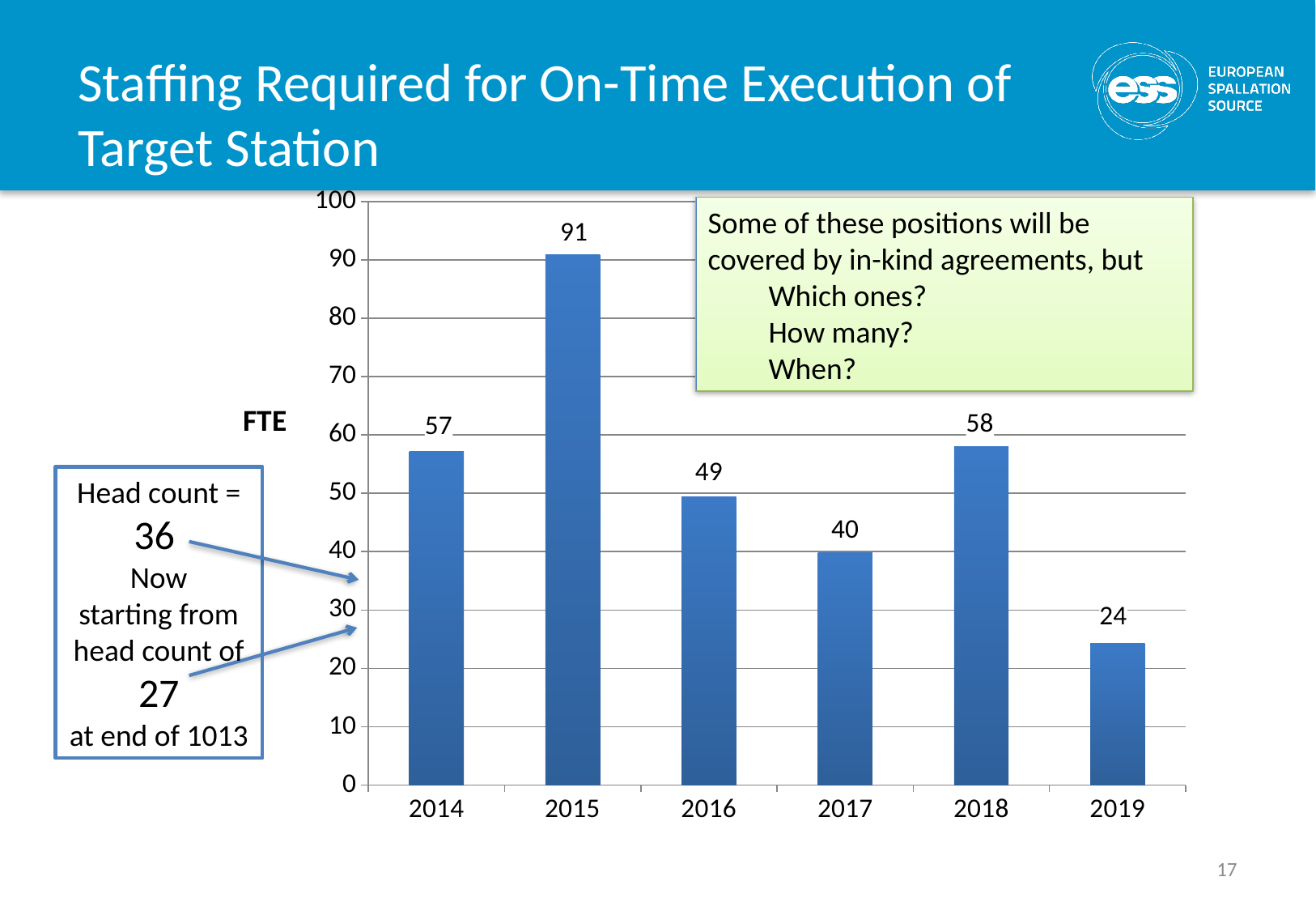
What is the difference between the FTE values for 2015 and 2016? 42 Which year has the lowest FTE value? 2019 Which year has a larger FTE value, 2014 or 2018? 2018 Which year has the highest FTE value? 2015 What is the FTE value for 2015? 91 What is the label on the vertical axis of the chart? FTE How many years are shown on the x axis of the chart? 6 What is the difference between the FTE values for 2018 and 2019? 34 What is the FTE value for 2019? 24 Is the FTE value for 2016 greater or less than 50? less What kind of chart is shown on the slide? bar chart What is the FTE value for 2017? 40